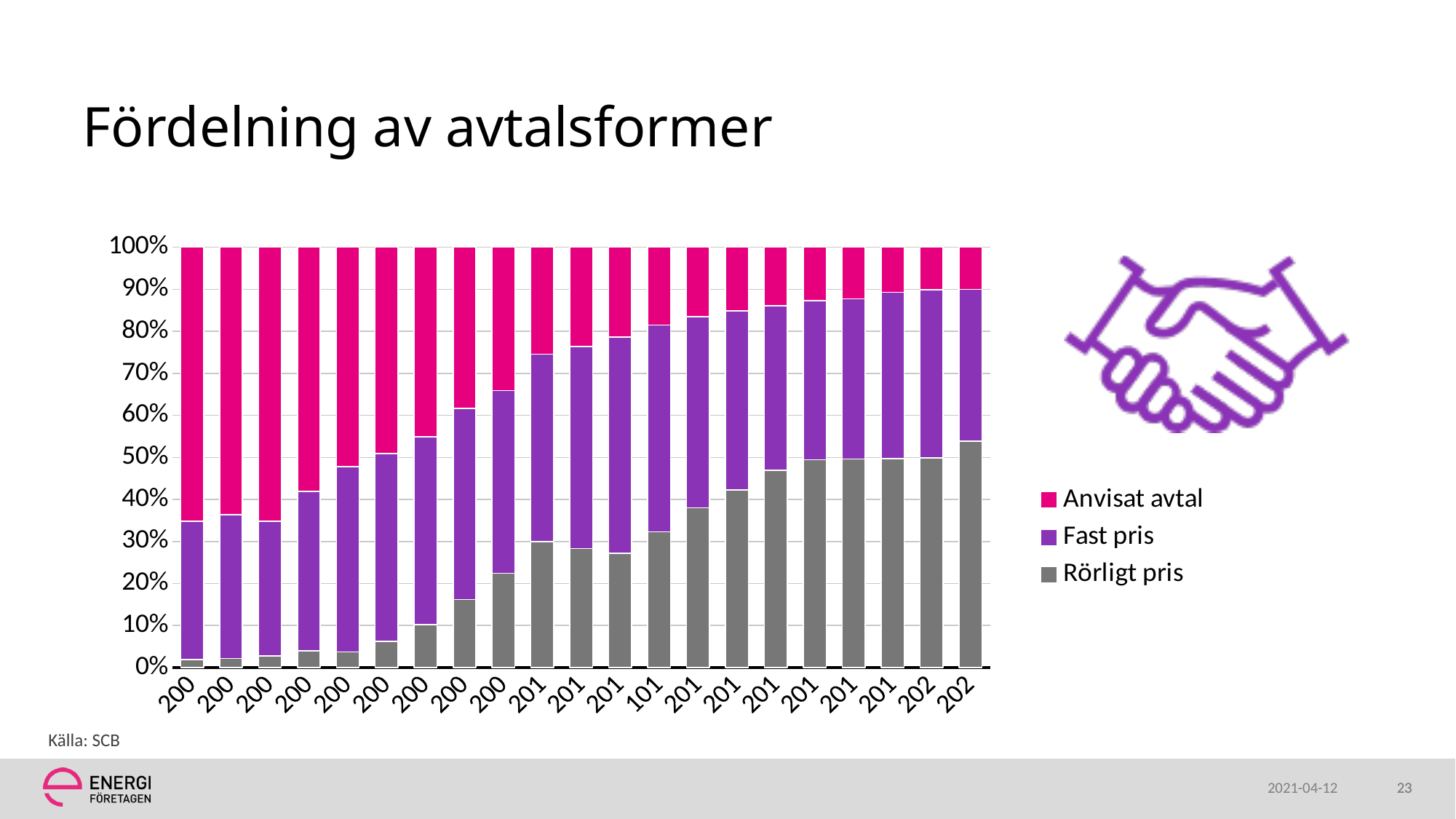
How many series does the legend list? 3 How many bars are plotted in the chart? 21 What is the title of the chart slide? Fördelning av avtalsformer In the leftmost bar, is the share of Rörligt pris greater or less than 10%? less Which colour represents Rörligt pris in the chart? Grey In the rightmost bar, is the share of Rörligt pris greater or less than 50%? greater What type of chart is shown on the slide? Stacked bar chart In the leftmost bar, which series has the largest share? Anvisat avtal Does the share of Anvisat avtal rise or fall from the leftmost bar to the rightmost bar? Fall What is the total of each stacked bar in the chart? 100% Does the share of Rörligt pris rise or fall from the leftmost bar to the rightmost bar? Rise In the rightmost bar, which is larger: the share of Rörligt pris or the share of Anvisat avtal? Rörligt pris